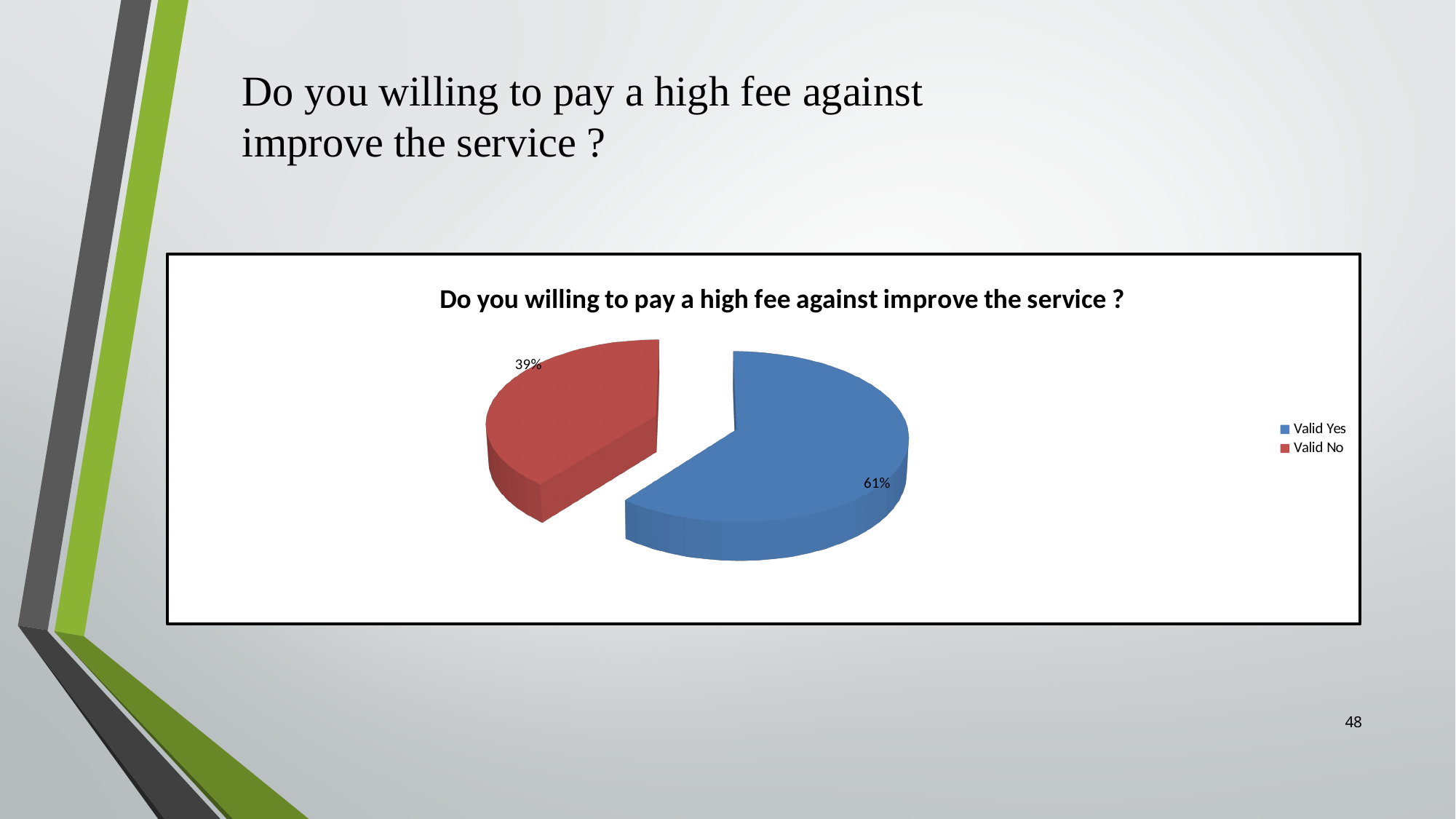
Which category has the smallest share of the pie? Valid No What is the title of the chart? Do you willing to pay a high fee against improve the service ? What percentage of respondents answered Valid No? 39% What is the difference in percentage points between Valid Yes and Valid No? 22 How many slices does the pie chart have? 2 Which is larger, the share for Valid Yes or the share for Valid No? Valid Yes What percentage of respondents answered Valid Yes? 61% Which category has the largest share of the pie? Valid Yes How many entries does the legend list? 2 What kind of chart is shown on the slide? pie chart What colour is the Valid No slice? red